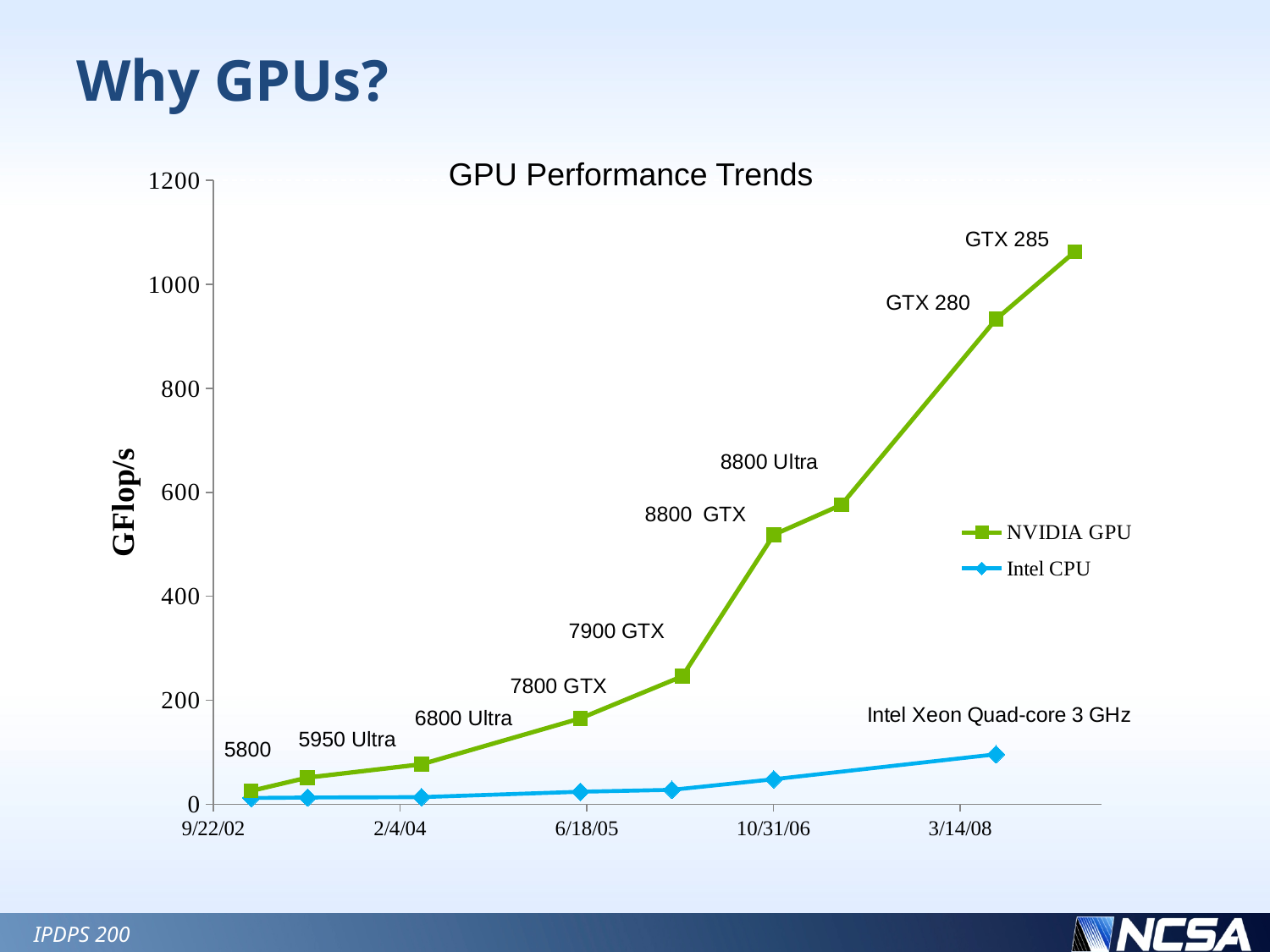
Is the value for GTX 280 greater or less than 1000? less Which has the larger GFlop/s value, GTX 280 or 8800 Ultra? GTX 280 How many series does the legend list? 2 Which labelled NVIDIA GPU has the highest GFlop/s value? GTX 285 Is the value for 8800 GTX greater or less than 400? greater Do the NVIDIA GPU values rise or fall over time along the x axis? rise What kind of chart is shown on the slide? line chart Is the value for Intel Xeon Quad-core 3 GHz greater or less than 200? less What is the label on the y axis? GFlop/s Which labelled NVIDIA GPU has the lowest GFlop/s value? 5800 What is the title of the chart? GPU Performance Trends